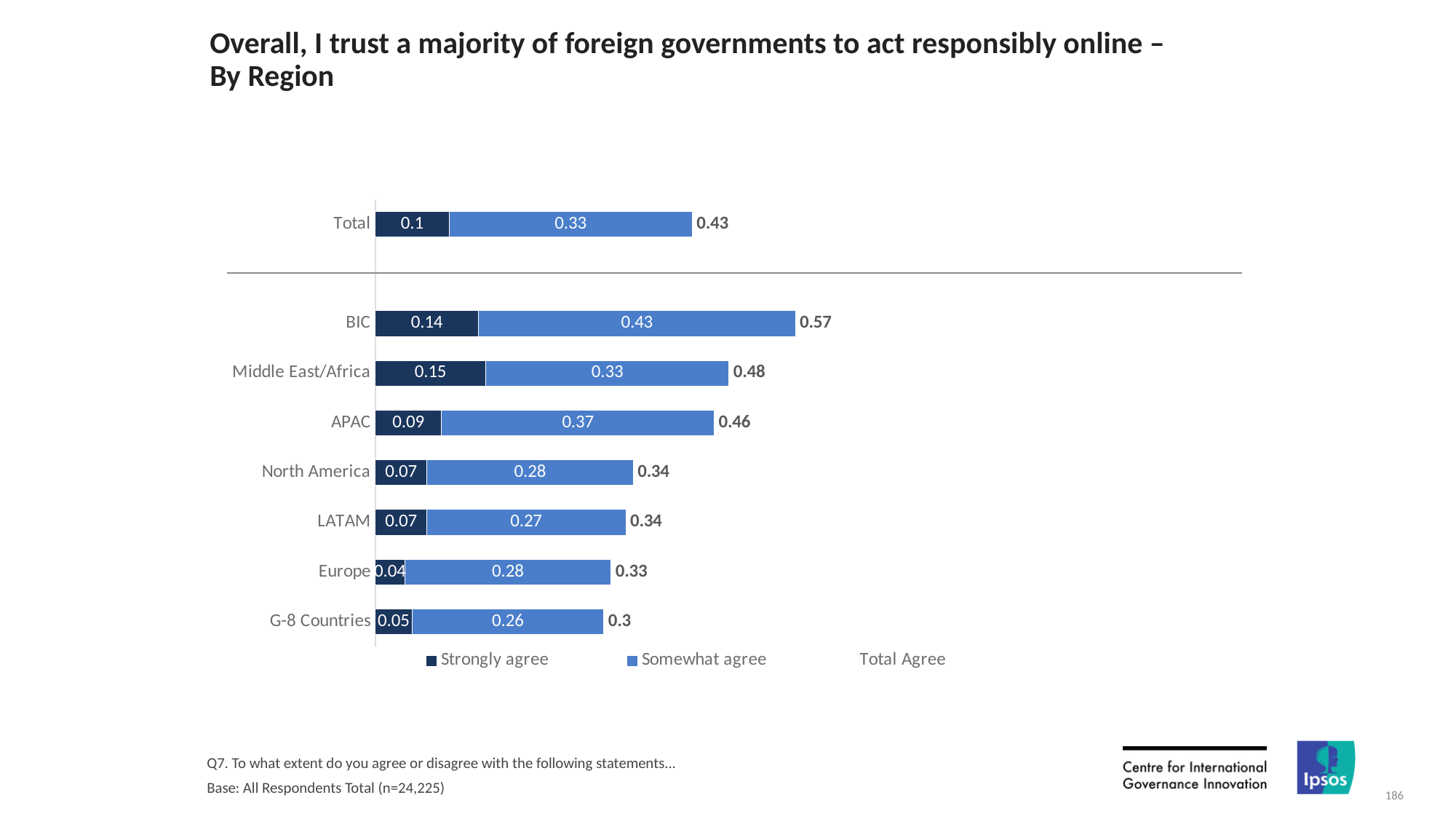
How many entries does the legend list? 3 What is the Somewhat agree value for APAC? 0.37 Which region has the highest Total Agree value? BIC What is the Total Agree value for the Total row? 0.43 Which region has the lowest Total Agree value? G-8 Countries How many region categories are shown on the chart, including Total? 8 What kind of chart is shown on the slide? Stacked bar chart What is the Strongly agree value for Europe? 0.04 What is the difference between the Total Agree values for BIC and G-8 Countries? 0.27 What is the Strongly agree value for BIC? 0.14 Which has a larger Somewhat agree value, Middle East/Africa or North America? Middle East/Africa What is the Total Agree value for Middle East/Africa? 0.48